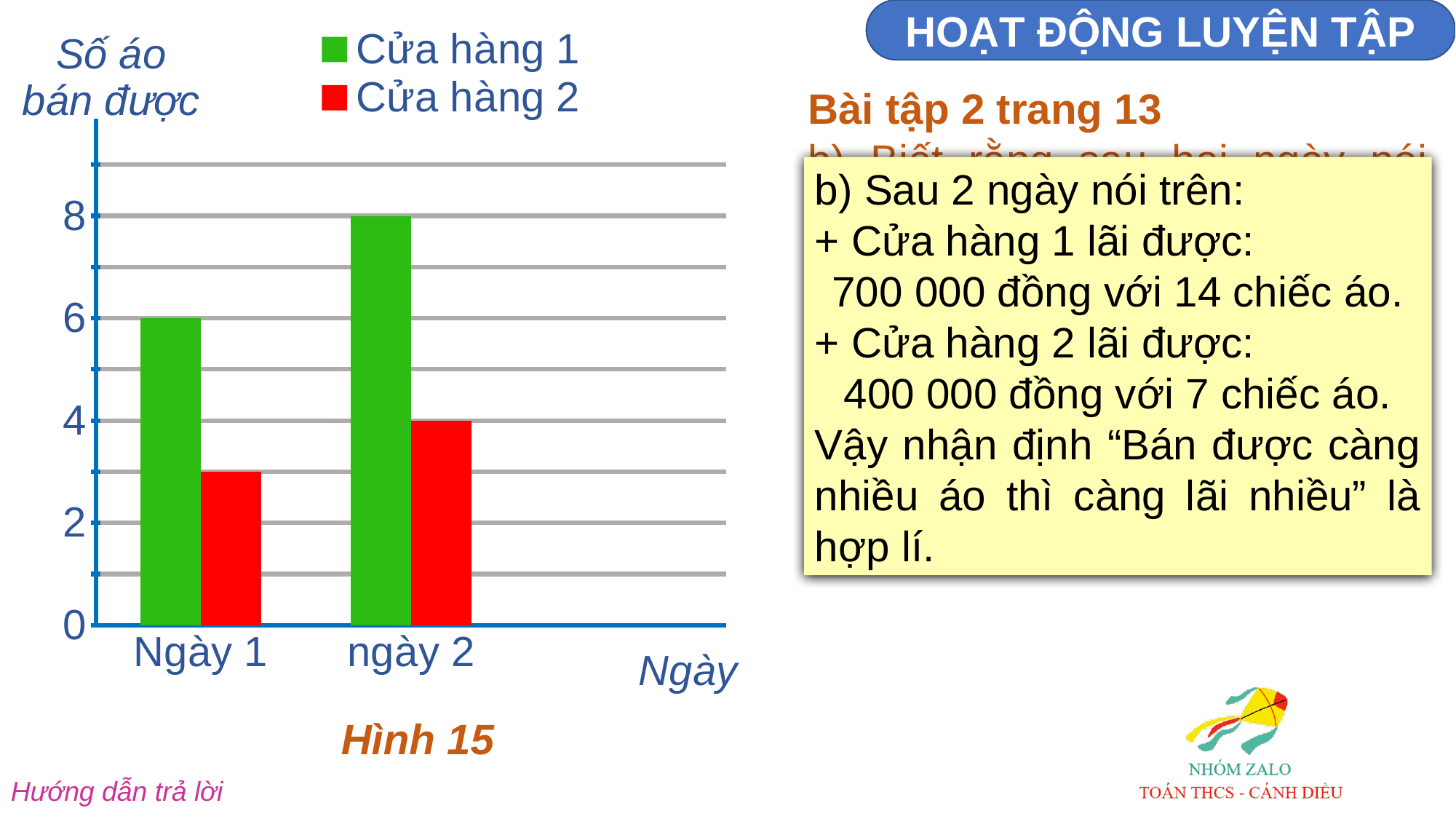
Which series has the lowest value on Ngày 1? Cửa hàng 2 What is the difference between the Cửa hàng 1 values on ngày 2 and Ngày 1? 2 Which day has the highest value for Cửa hàng 1? ngày 2 Which colour represents Cửa hàng 2 in the chart? red What is the value for Cửa hàng 1 on ngày 2? 8 How many series does the legend of the chart list? 2 What is the value for Cửa hàng 1 on Ngày 1? 6 What kind of chart is shown in Hình 15? bar chart Is the value for Cửa hàng 2 on Ngày 1 greater or less than 4? less Which is larger on ngày 2: Cửa hàng 1 or Cửa hàng 2? Cửa hàng 1 What is the value for Cửa hàng 2 on ngày 2? 4 How many categories are shown on the x axis of the chart? 2